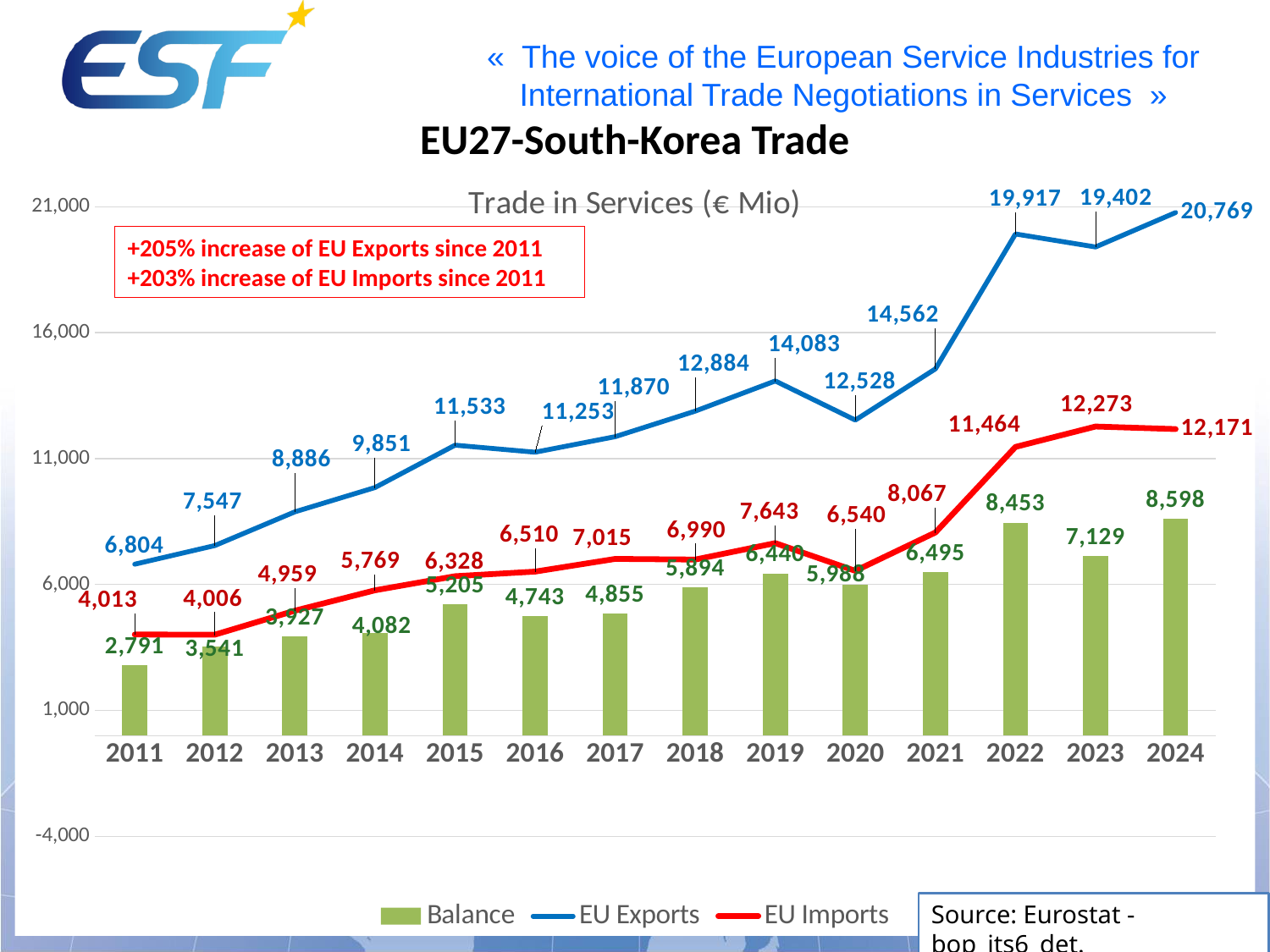
Is the value for EU Exports in 2022 greater or less than 16,000? greater What is the Balance value for 2022? 8,453 In which year are EU Exports highest? 2024 By how much did EU Exports increase from 2011 to 2024? 13,965 What is the value of EU Imports in 2011? 4,013 Which year has the larger EU Imports value, 2023 or 2024? 2023 What kind of chart is this? Combined bar and line chart What is the value of EU Exports in 2024? 20,769 According to the text box on the chart, by what percentage have EU Exports increased since 2011? +205% How many years are shown on the x axis? 14 In which year is the Balance lowest? 2011 How many series does the legend list? 3